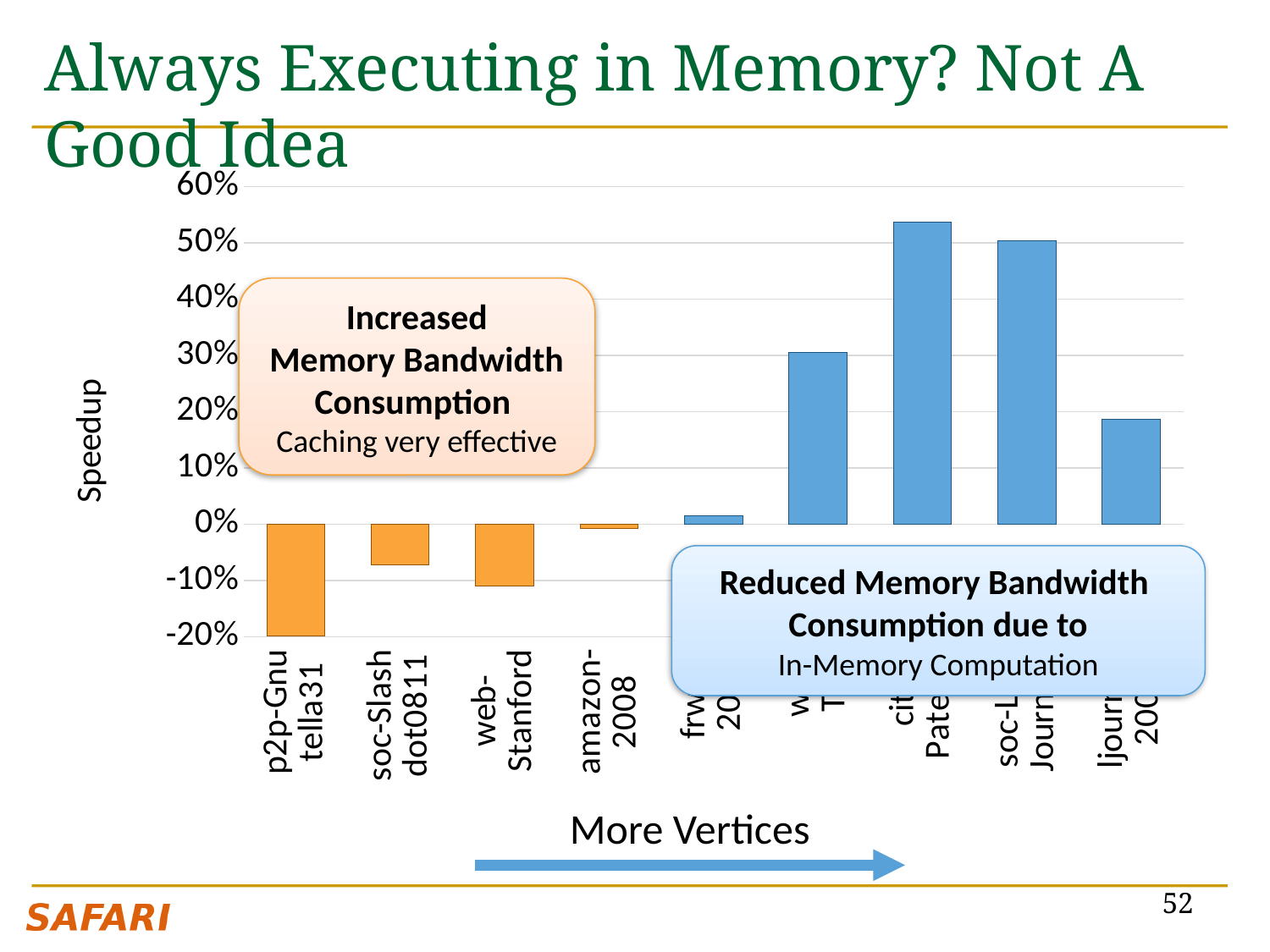
Is the speedup for p2p-Gnutella31 greater or less than -10%? less What kind of chart is shown on the slide? bar chart Which has the larger speedup, soc-Slashdot0811 or web-Stanford? soc-Slashdot0811 Which has the larger speedup, p2p-Gnutella31 or amazon-2008? amazon-2008 Do the speedup values generally rise or fall moving left to right along the x axis (toward more vertices)? rise What colour are the bars with negative speedup? orange What is the label of the y axis? Speedup Is the speedup for amazon-2008 greater or less than 0%? less How many bars (categories) are plotted in the chart? 9 Is the speedup for soc-Slashdot0811 greater or less than -10%? greater Which category has the lowest speedup? p2p-Gnutella31